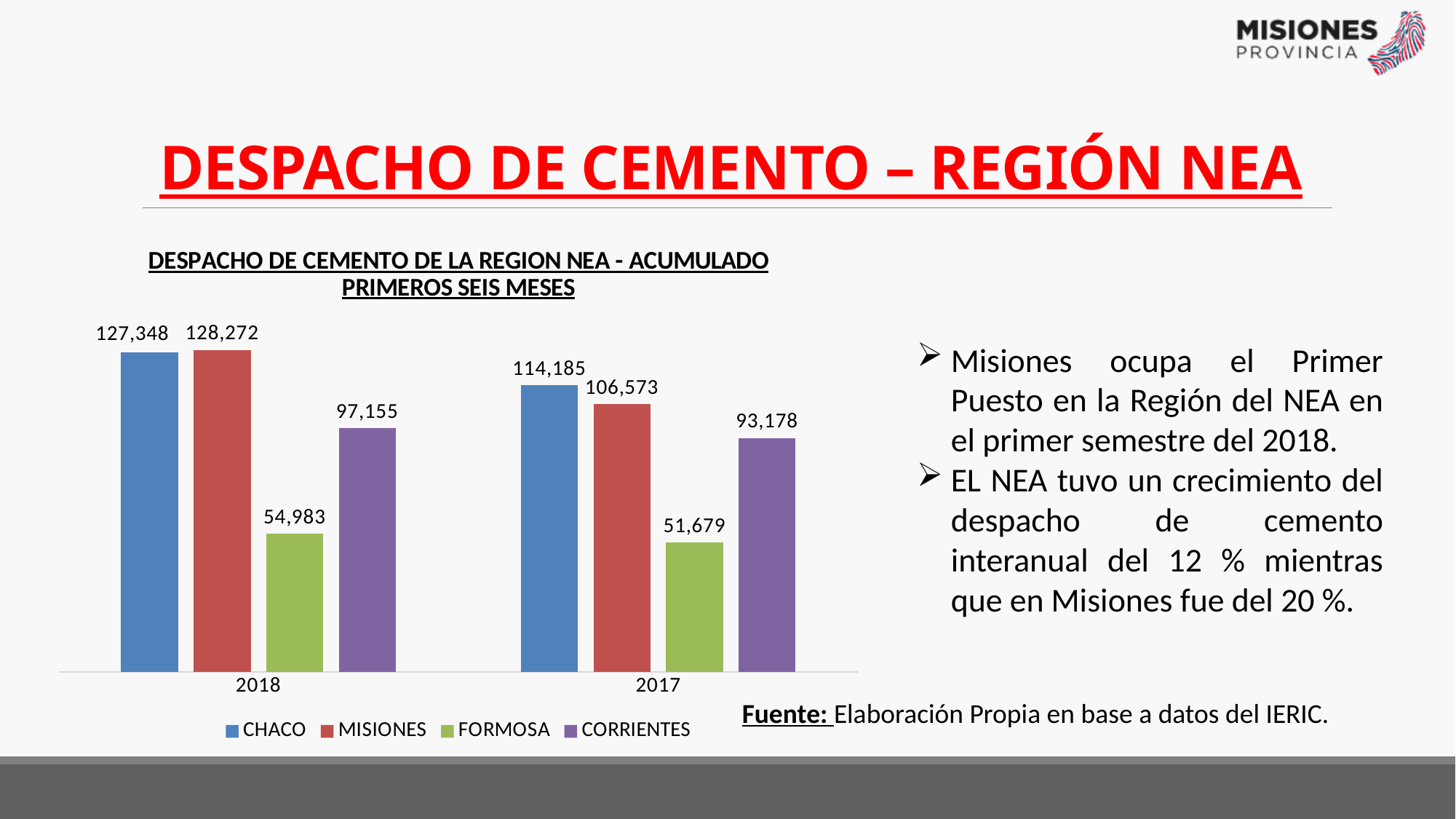
What is the difference between MISIONES in 2018 and MISIONES in 2017? 21,699 Which province has the lowest value in 2017? FORMOSA What is the value for CORRIENTES in 2018? 97,155 Which province has the highest value in 2018? MISIONES What colour represents FORMOSA in the chart? Green What is the value for MISIONES in 2018? 128,272 How many series does the legend list? 4 Which is larger: CHACO in 2017 or MISIONES in 2017? CHACO in 2017 How many year categories are shown on the x axis? 2 What is the value for FORMOSA in 2017? 51,679 What kind of chart is shown on the slide? Bar chart What is the value for CHACO in 2017? 114,185